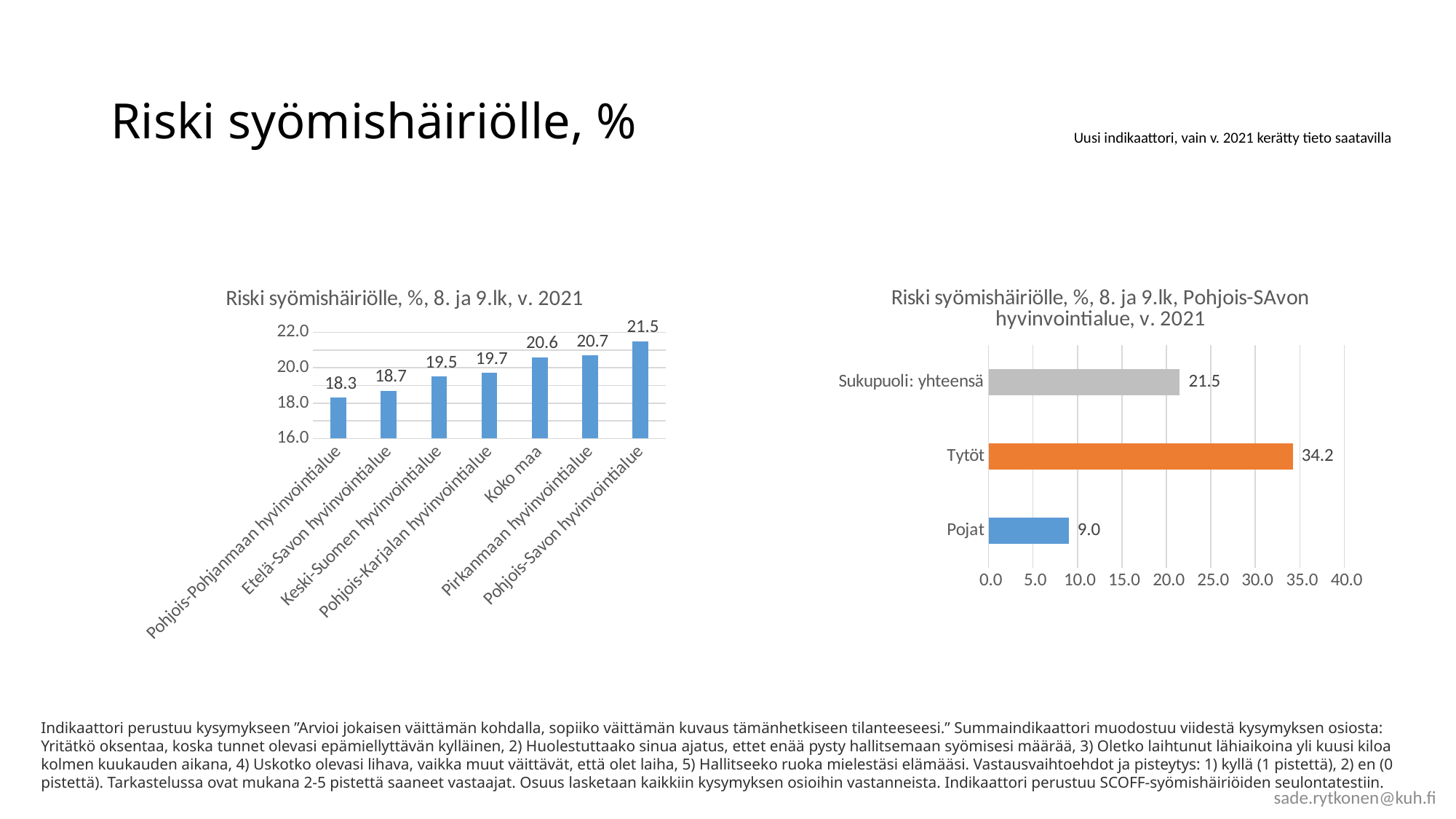
In the right chart 'Riski syömishäiriölle, %, 8. ja 9.lk, Pohjois-SAvon hyvinvointialue, v. 2021', what is the value for Tytöt? 34.2 In the right chart 'Riski syömishäiriölle, %, 8. ja 9.lk, Pohjois-SAvon hyvinvointialue, v. 2021', what is the value for Pojat? 9.0 In the left chart 'Riski syömishäiriölle, %, 8. ja 9.lk, v. 2021', which category has the highest value? Pohjois-Savon hyvinvointialue In the left chart 'Riski syömishäiriölle, %, 8. ja 9.lk, v. 2021', what is the value for Pohjois-Pohjanmaan hyvinvointialue? 18.3 In the right chart 'Riski syömishäiriölle, %, 8. ja 9.lk, Pohjois-SAvon hyvinvointialue, v. 2021', which is larger, Tytöt or Sukupuoli: yhteensä? Tytöt In the left chart 'Riski syömishäiriölle, %, 8. ja 9.lk, v. 2021', what is the difference between Pohjois-Savon hyvinvointialue and Koko maa? 0.9 What kind of chart is the right chart 'Riski syömishäiriölle, %, 8. ja 9.lk, Pohjois-SAvon hyvinvointialue, v. 2021'? bar chart In the left chart 'Riski syömishäiriölle, %, 8. ja 9.lk, v. 2021', what is the value for Koko maa? 20.6 In the left chart 'Riski syömishäiriölle, %, 8. ja 9.lk, v. 2021', do the values rise or fall from left to right? rise In the left chart 'Riski syömishäiriölle, %, 8. ja 9.lk, v. 2021', how many categories are shown? 7 In the left chart 'Riski syömishäiriölle, %, 8. ja 9.lk, v. 2021', which category has the lowest value? Pohjois-Pohjanmaan hyvinvointialue In the right chart 'Riski syömishäiriölle, %, 8. ja 9.lk, Pohjois-SAvon hyvinvointialue, v. 2021', what is the difference between Tytöt and Pojat? 25.2